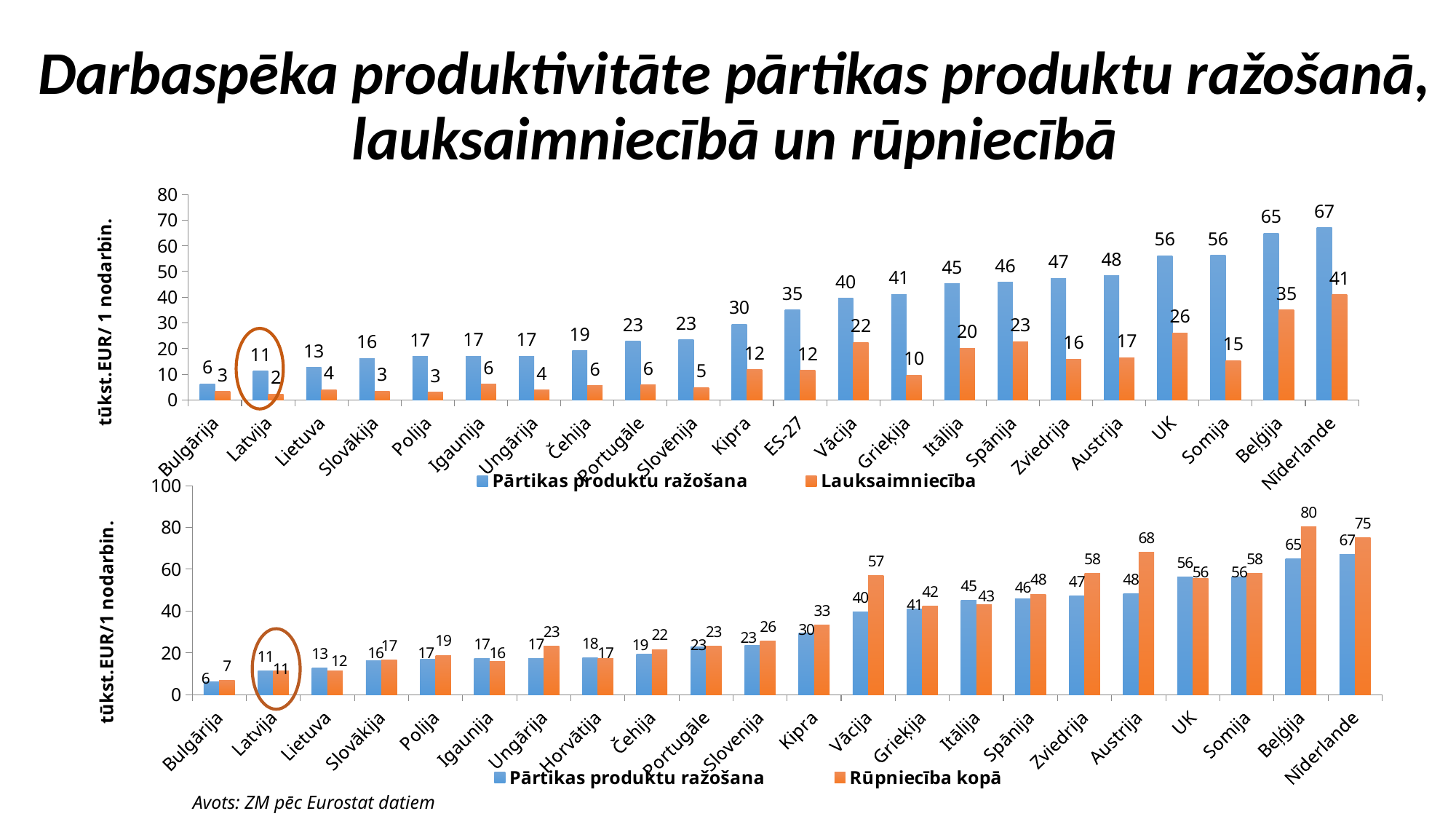
In the top chart, what is the Pārtikas produktu ražošana value for Vācija? 40 In the bottom chart, which is larger for Vācija: Pārtikas produktu ražošana or Rūpniecība kopā? Rūpniecība kopā In the bottom chart, what is the Rūpniecība kopā value for Austrija? 68 In the top chart, what is the Lauksaimniecība value for Latvija? 2 In the bottom chart, which country has the highest Rūpniecība kopā value? Beļģija In the top chart, which country has the highest Lauksaimniecība value? Nīderlande In the top chart, how many series does the legend list? 2 In the bottom chart, how many countries are shown on the x axis? 22 What type of chart is the bottom chart? Bar chart In the top chart, do the Pārtikas produktu ražošana values generally rise or fall from left to right? Rise In the bottom chart, which country has the lowest Pārtikas produktu ražošana value? Bulgārija In the top chart, what is the difference between the Pārtikas produktu ražošana and Lauksaimniecība values for Beļģija? 30